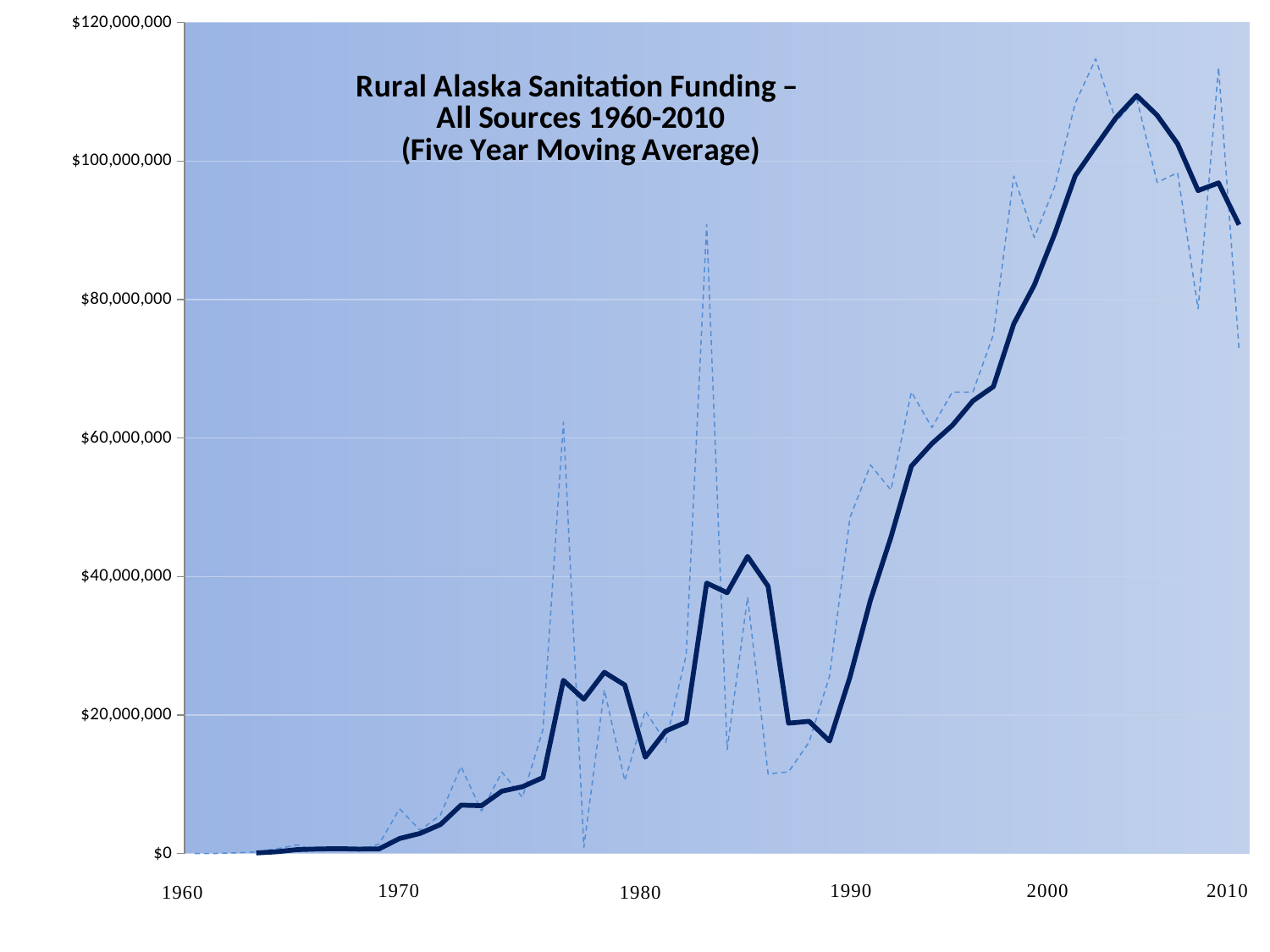
Which year has the larger value on the solid line, 1990 or 2000? 2000 Overall, does the solid line rise or fall from 1960 to 2010? Rise What is the highest value shown on the y axis? $120,000,000 What kind of chart is shown on the slide? Line chart How many lines are plotted on the chart? 2 Is the highest point of the solid line greater or less than $100,000,000? greater What is the title of the chart? Rural Alaska Sanitation Funding – All Sources 1960-2010 (Five Year Moving Average) Does the solid line rise or fall between 2005 and 2010? Fall How many year labels are shown on the x axis? 6 Is the value of the solid line at 2000 greater or less than $80,000,000? greater Is the value of the solid line at 1990 greater or less than $40,000,000? less